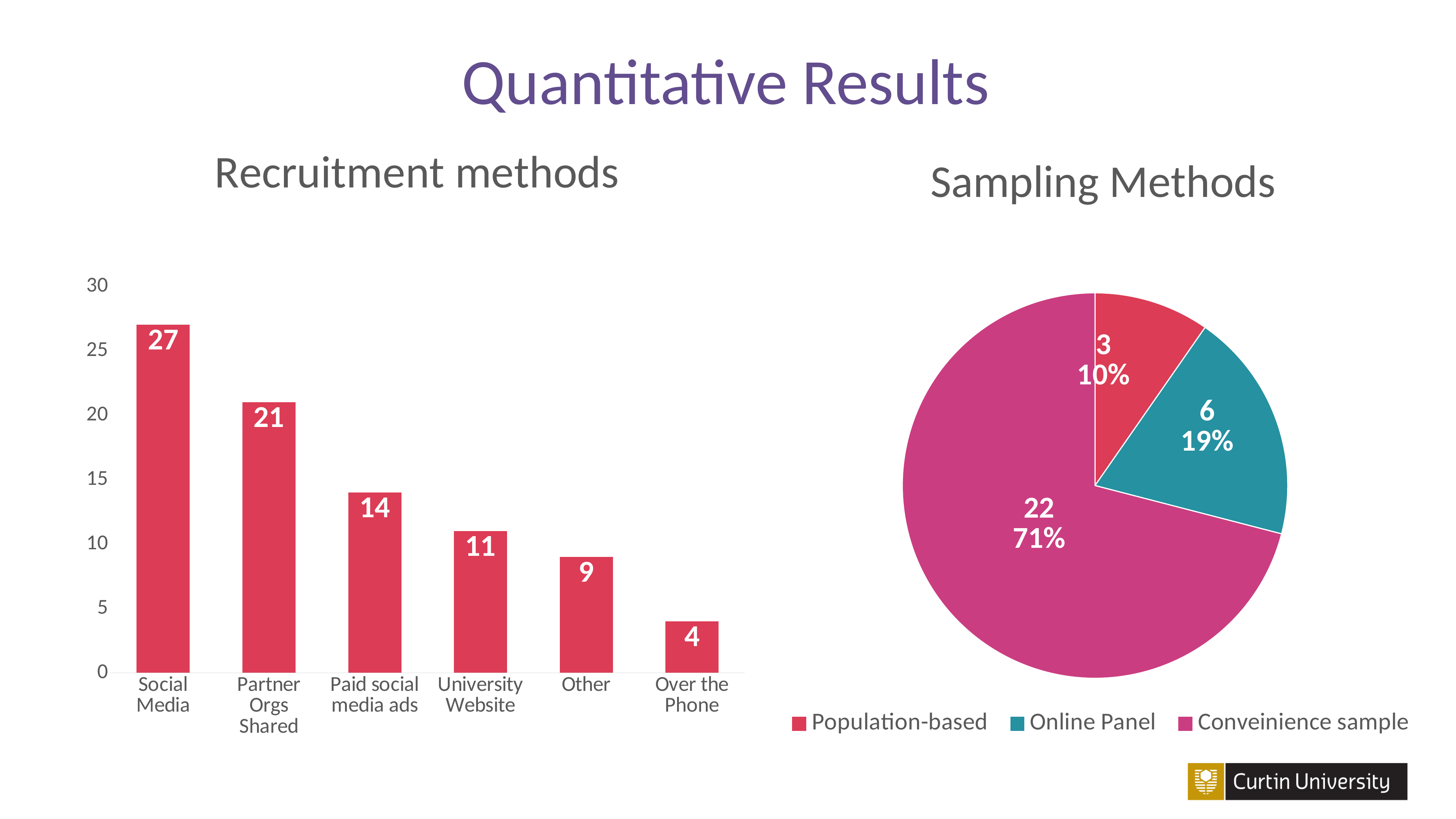
In the Recruitment methods chart, which recruitment method has the lowest value? Over the Phone In the Recruitment methods chart, what is the value for Paid social media ads? 14 In the Recruitment methods chart, do the values rise or fall from left to right? fall In the Recruitment methods chart, what is the value for Social Media? 27 What kind of chart is the Recruitment methods chart? bar chart In the Recruitment methods chart, which recruitment method has the highest value? Social Media In the Recruitment methods chart, which is larger, University Website or Other? University Website In the Sampling Methods chart, what is the value for Conveinience sample? 22 In the Recruitment methods chart, what is the difference between Social Media and Partner Orgs Shared? 6 How many entries does the legend of the Sampling Methods chart list? 3 How many categories are shown in the Recruitment methods chart? 6 In the Sampling Methods chart, what share of the pie is Online Panel? 19%